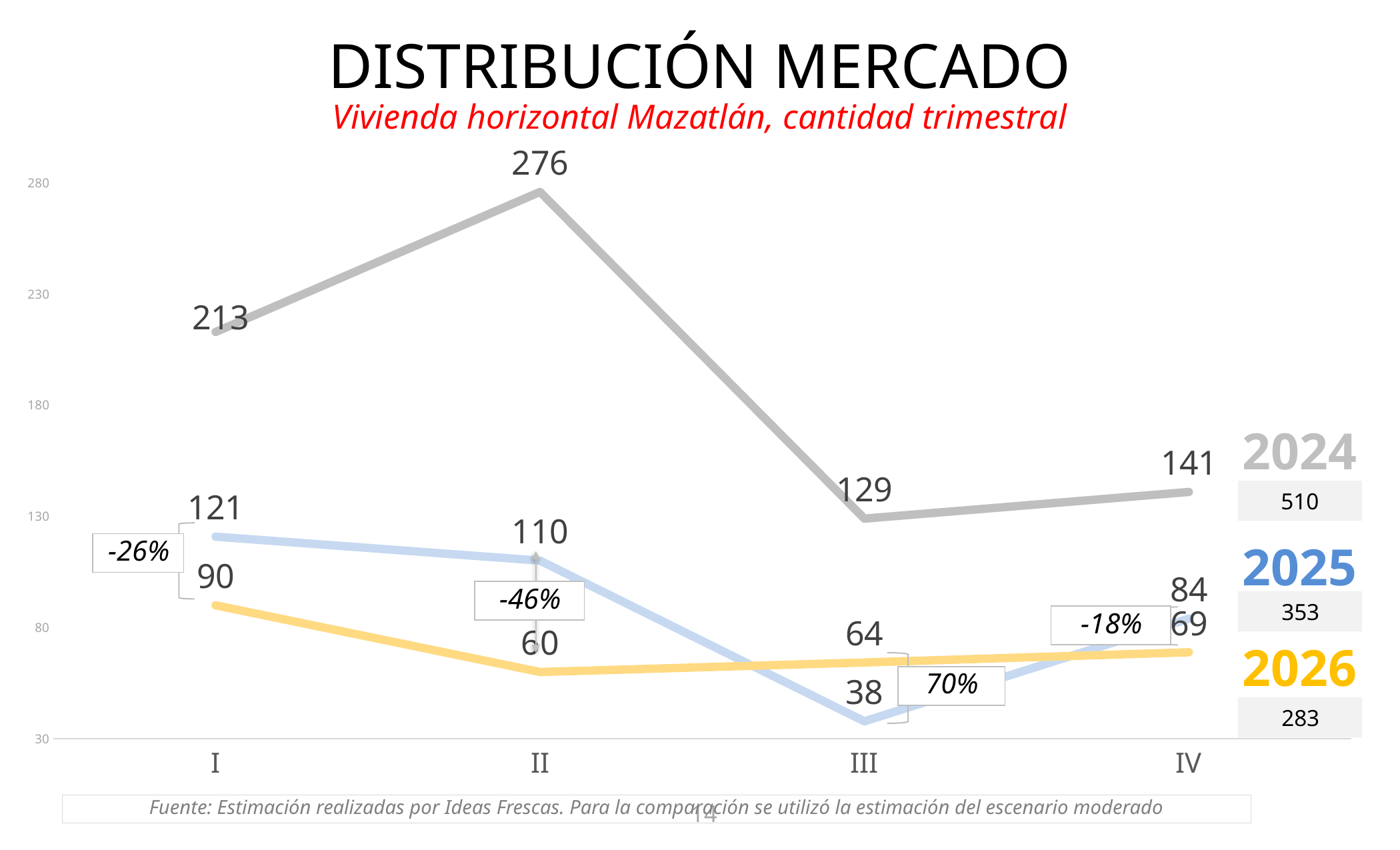
What is the 2024 value for quarter II? 276 What annual total is shown next to the 2025 label? 353 How many series (years) are plotted on the chart? 3 What is the 2025 value for quarter III? 38 What is the difference between the 2024 and 2025 values in quarter I? 92 Which is larger in quarter III, the 2026 value or the 2025 value? 2026 In which quarter does the 2025 series reach its lowest value? III What is the 2026 value for quarter I? 90 What kind of chart is shown on the slide? line chart Does the 2024 series rise or fall from quarter II to quarter III? fall How many quarters are plotted on the x axis? 4 In which quarter does the 2024 series reach its highest value? II